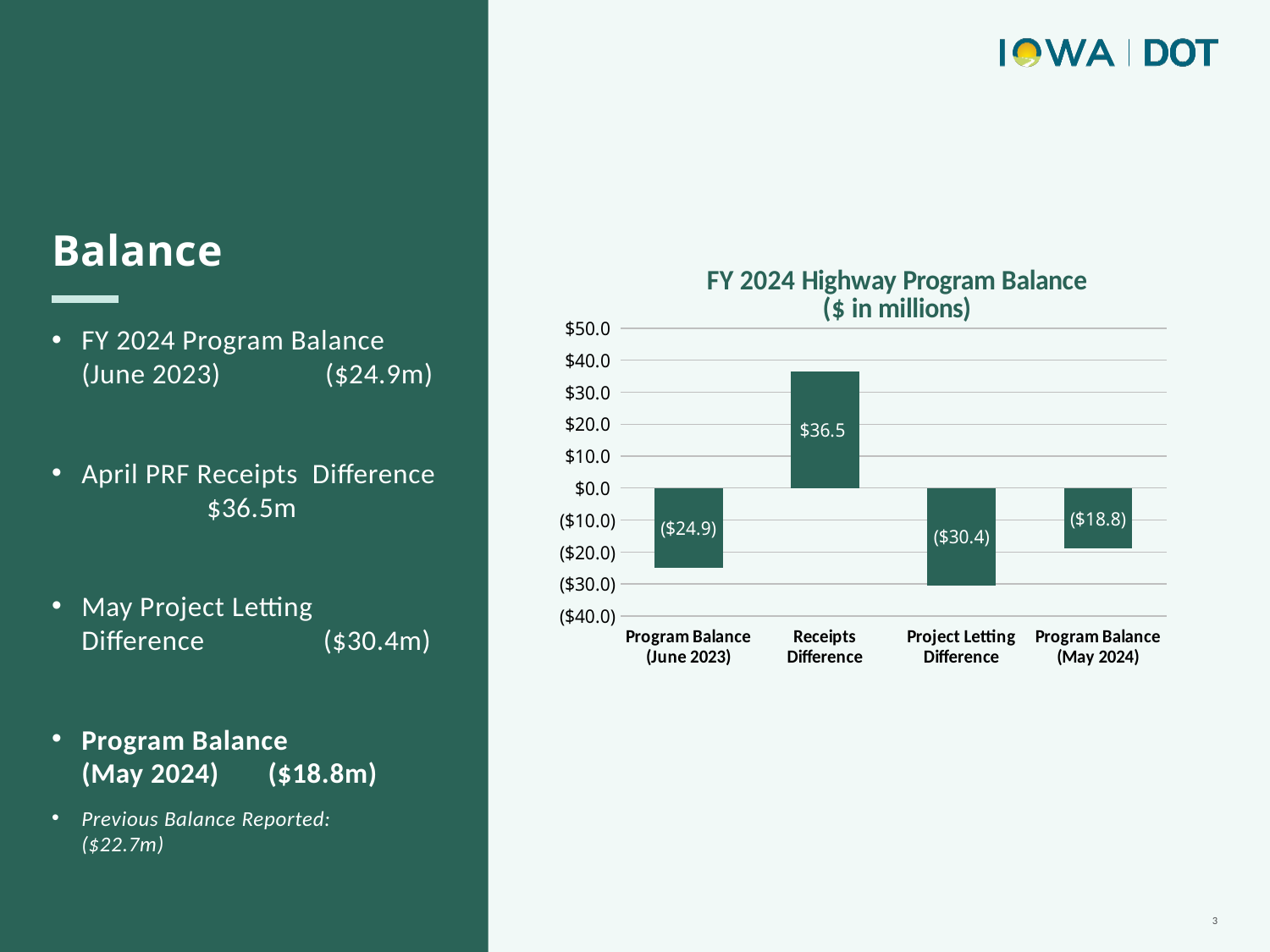
What kind of chart is shown on the slide? Bar chart What is the value for Program Balance (June 2023) in the chart? ($24.9) What is the value for Receipts Difference in the FY 2024 Highway Program Balance chart? $36.5 Which is larger in the chart: the value for Program Balance (June 2023) or the value for Program Balance (May 2024)? Program Balance (May 2024) How many categories are shown on the x axis of the chart? 4 Is the value for Receipts Difference greater or less than $30.0? greater Which category has the highest value in the FY 2024 Highway Program Balance chart? Receipts Difference Is the value for Project Letting Difference greater or less than ($20.0)? less What is the value for Program Balance (May 2024) in the chart? ($18.8) What is the value for Project Letting Difference in the chart? ($30.4) What is the title of the chart on the slide? FY 2024 Highway Program Balance ($ in millions) Which category has the lowest value in the FY 2024 Highway Program Balance chart? Project Letting Difference